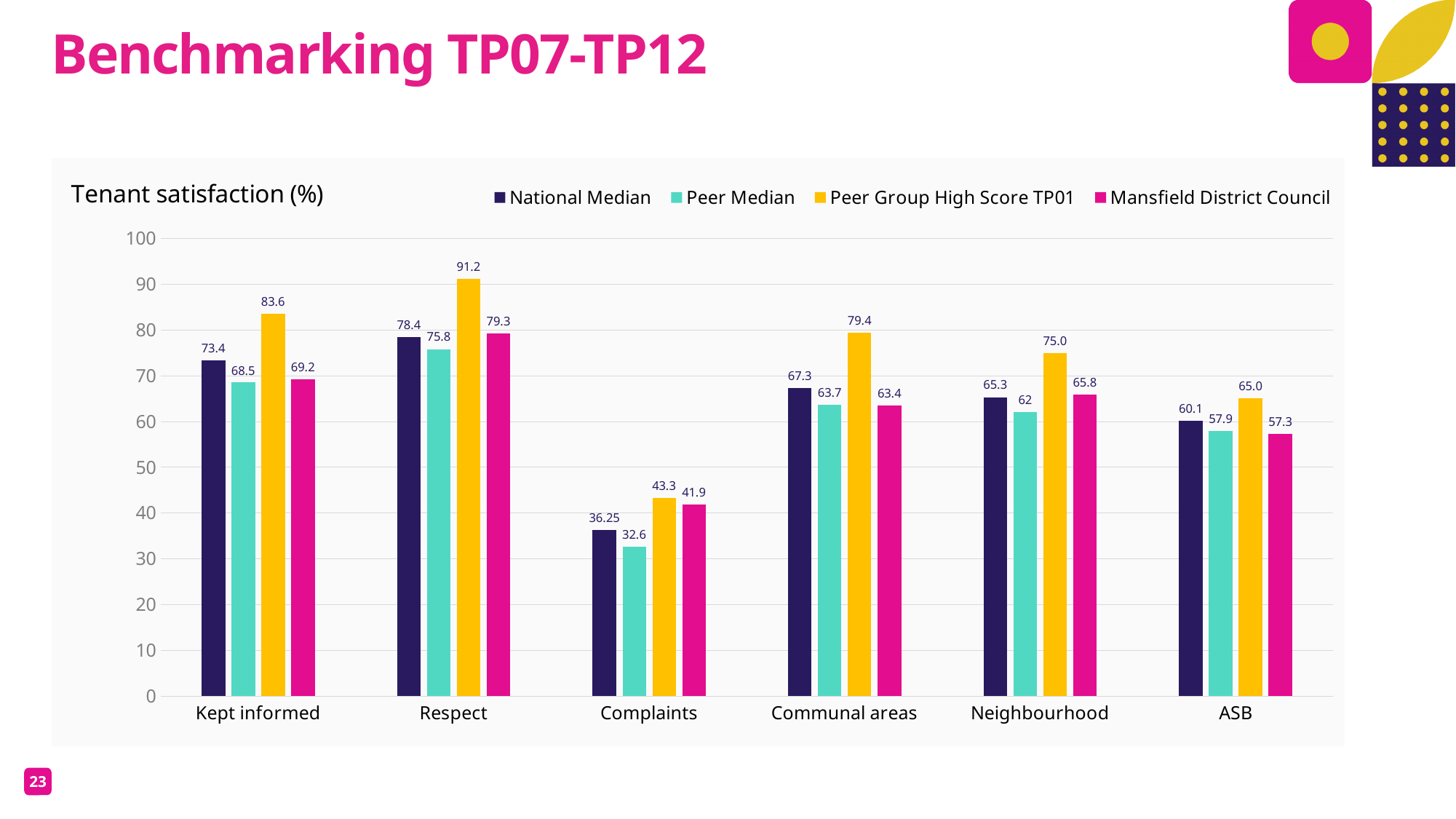
Which category has the highest Peer Group High Score TP01 value? Respect What is the title of the chart? Tenant satisfaction (%) What is the Mansfield District Council value for Respect? 79.3 What kind of chart is shown on the slide? Bar chart What is the difference between the Peer Group High Score TP01 and the Mansfield District Council values for Kept informed? 14.4 What is the Peer Median value for Complaints? 32.6 How many categories are shown on the x axis? 6 Which category has the lowest Mansfield District Council value? Complaints For Neighbourhood, which is larger: the National Median or the Mansfield District Council value? Mansfield District Council What is the National Median value for Communal areas? 67.3 Is the Peer Median value for ASB greater or less than 60? less How many series does the legend list? 4